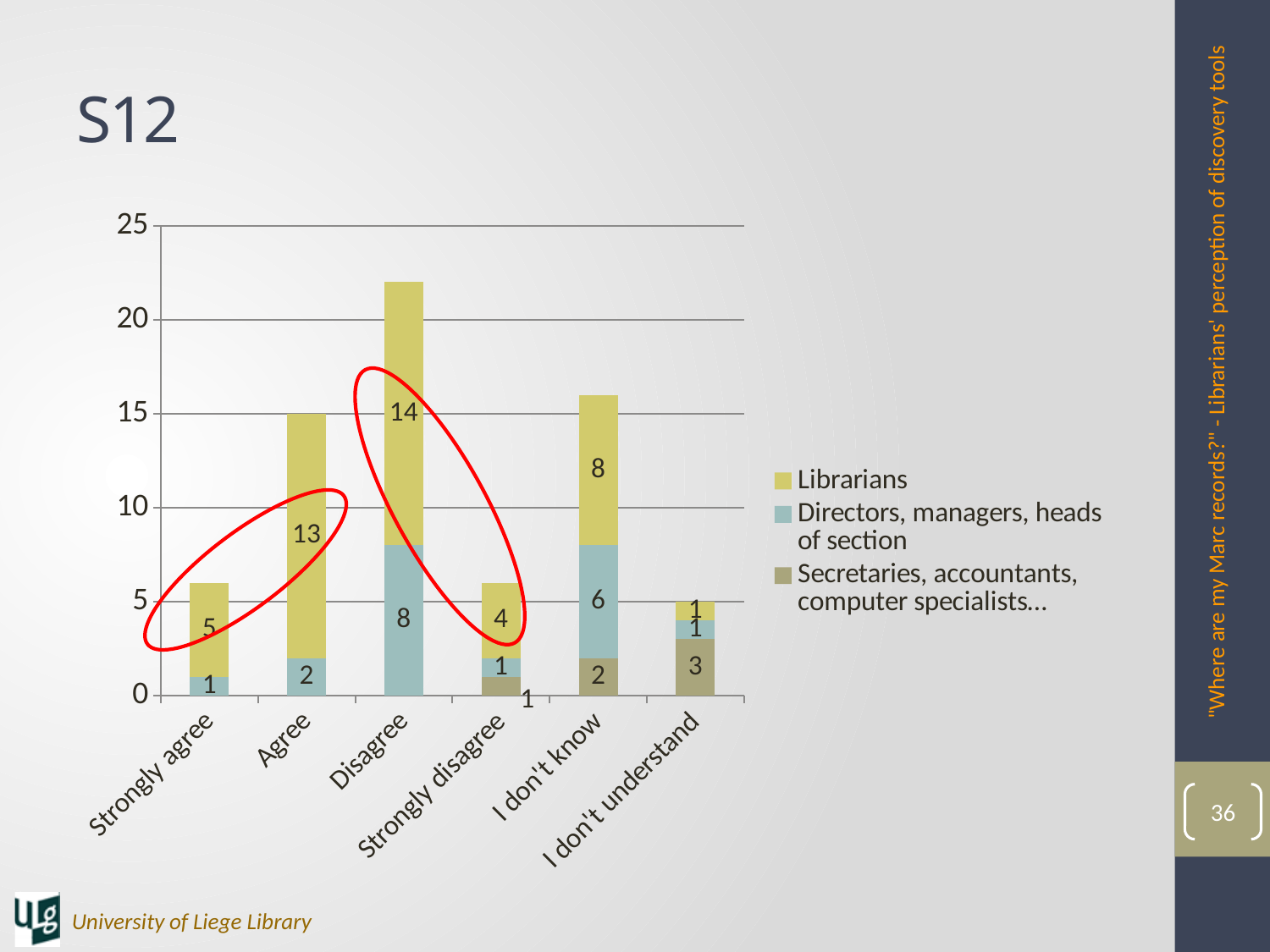
How many categories are shown on the x axis? 6 How many series does the legend list? 3 Which category has the lowest Librarians value? I don't understand What is the total of the stacked bar for I don't know? 16 What is the difference between the Librarians values for Agree and Strongly agree? 8 What is the Librarians value for Disagree? 14 Which category has the highest Librarians value? Disagree What is the value for Directors, managers, heads of section for I don't know? 6 What is the total of the stacked bar for Disagree? 22 What type of chart is shown on the slide? Stacked bar chart What is the value for Secretaries, accountants, computer specialists for I don't understand? 3 Which is larger: the Librarians value for I don't know or the Librarians value for Strongly disagree? I don't know